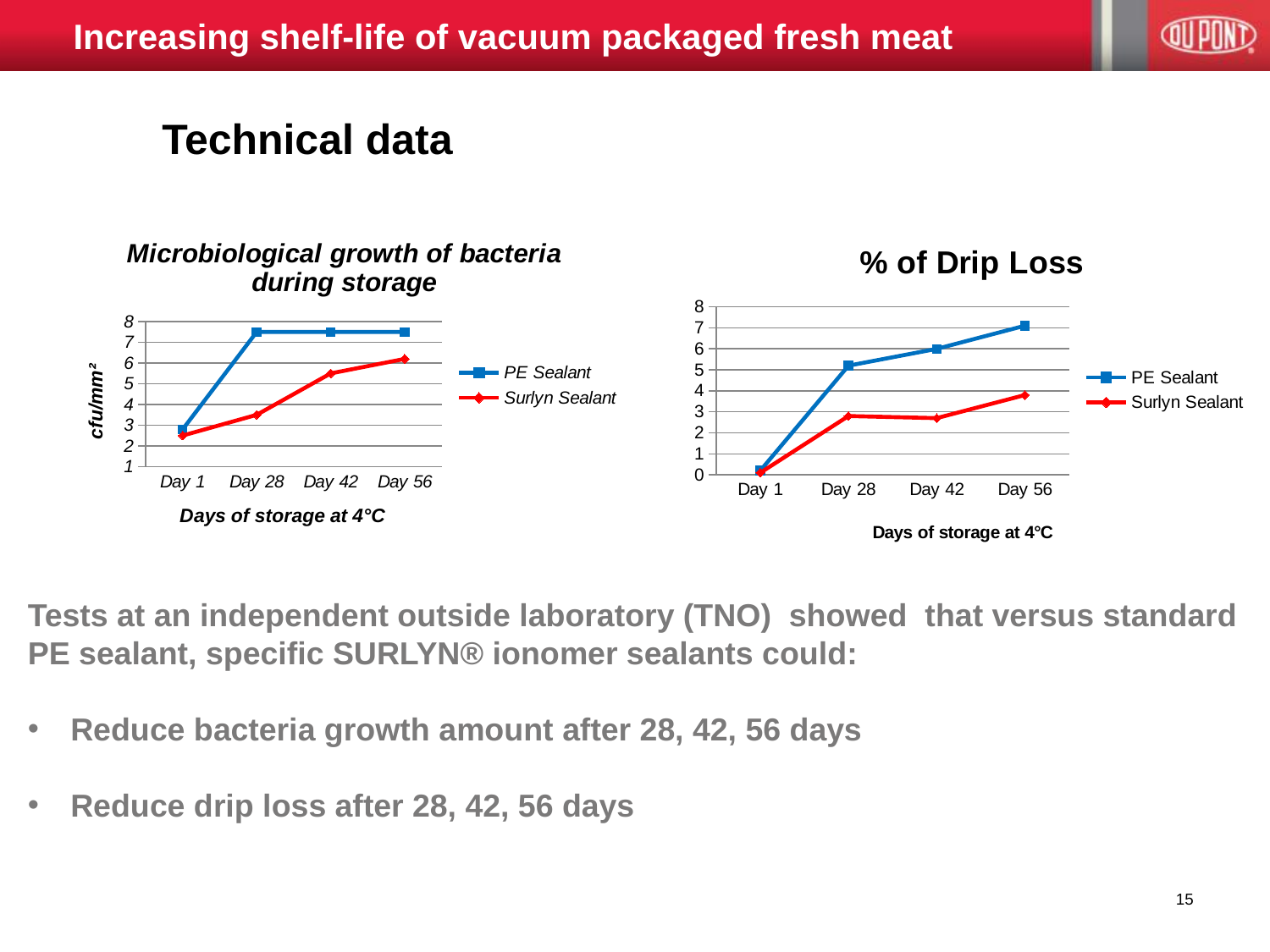
In the '% of Drip Loss' chart, at which day does the PE Sealant series reach its highest value? Day 56 What is the x-axis title of the '% of Drip Loss' chart? Days of storage at 4°C In the '% of Drip Loss' chart, is the Surlyn Sealant value at Day 56 greater or less than 3? greater In the 'Microbiological growth of bacteria during storage' chart, is the Surlyn Sealant value at Day 28 greater or less than 4? less In the '% of Drip Loss' chart on the right, how many series does the legend list? 2 In the '% of Drip Loss' chart, is the PE Sealant value at Day 28 greater or less than 4? greater In the '% of Drip Loss' chart, which series has the larger value at Day 56, PE Sealant or Surlyn Sealant? PE Sealant In the 'Microbiological growth of bacteria during storage' chart, at which day is the Surlyn Sealant value lowest? Day 1 What kind of chart is the 'Microbiological growth of bacteria during storage' chart on the left? line chart In the 'Microbiological growth of bacteria during storage' chart, how many storage-day categories are shown on the x axis? 4 In the '% of Drip Loss' chart, does the PE Sealant series rise or fall from Day 1 to Day 56? rise